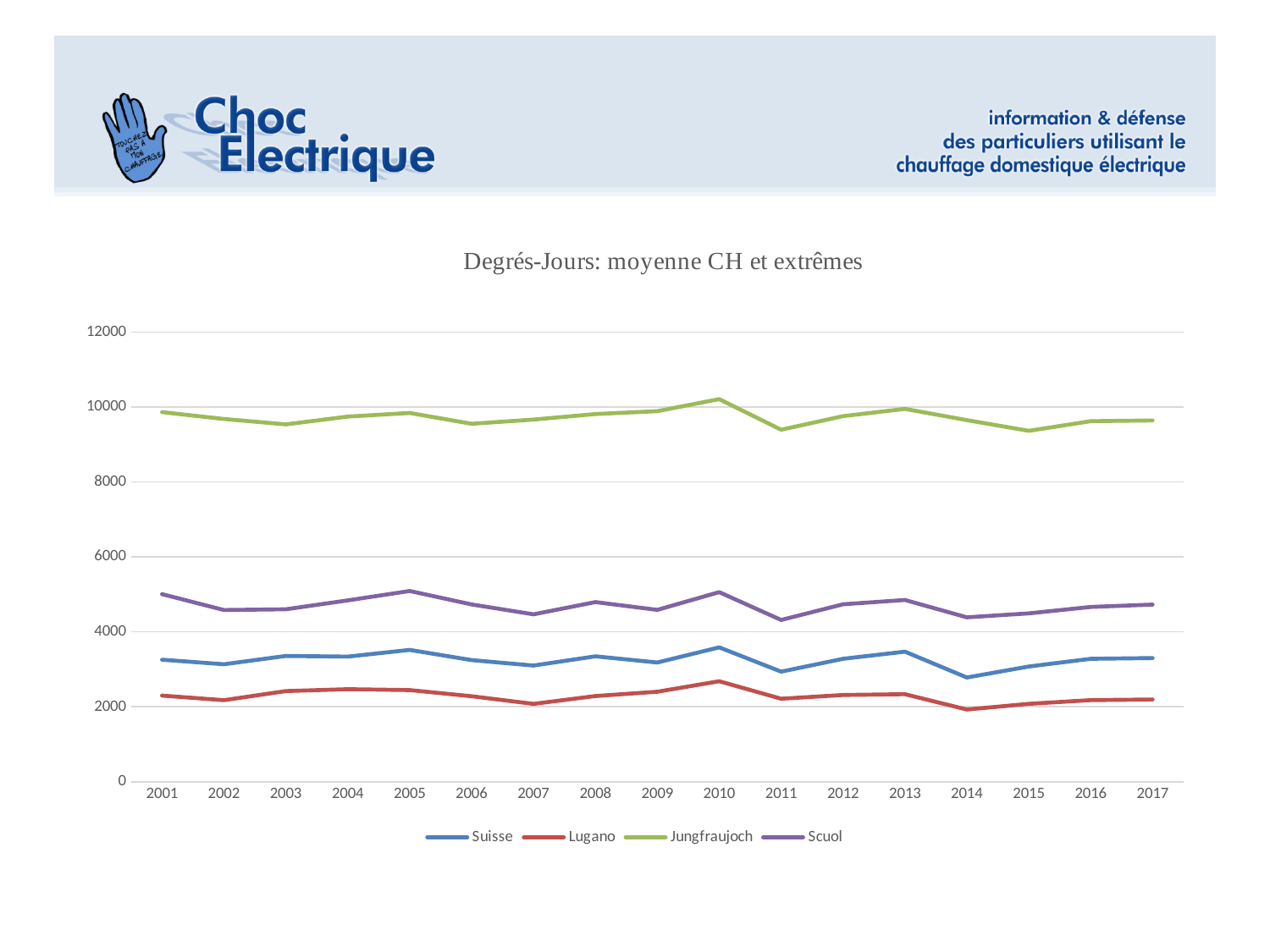
Which is larger, the Scuol value in 2010 or the Scuol value in 2011? 2010 In which year does the Jungfraujoch series reach its highest value? 2010 Which series has the highest values across all years? Jungfraujoch Does the Suisse series rise or fall from 2014 to 2017? rise What is the title of the chart? Degrés-Jours: moyenne CH et extrêmes Is the value for Jungfraujoch in 2011 greater or less than 10000? less What kind of chart is shown on the slide? line chart Is the value for Jungfraujoch in 2010 greater or less than 10000? greater How many series does the legend list? 4 How many years are shown along the x axis? 17 Which series has the lowest values across all years? Lugano Is the value for Scuol in 2005 greater or less than 4000? greater